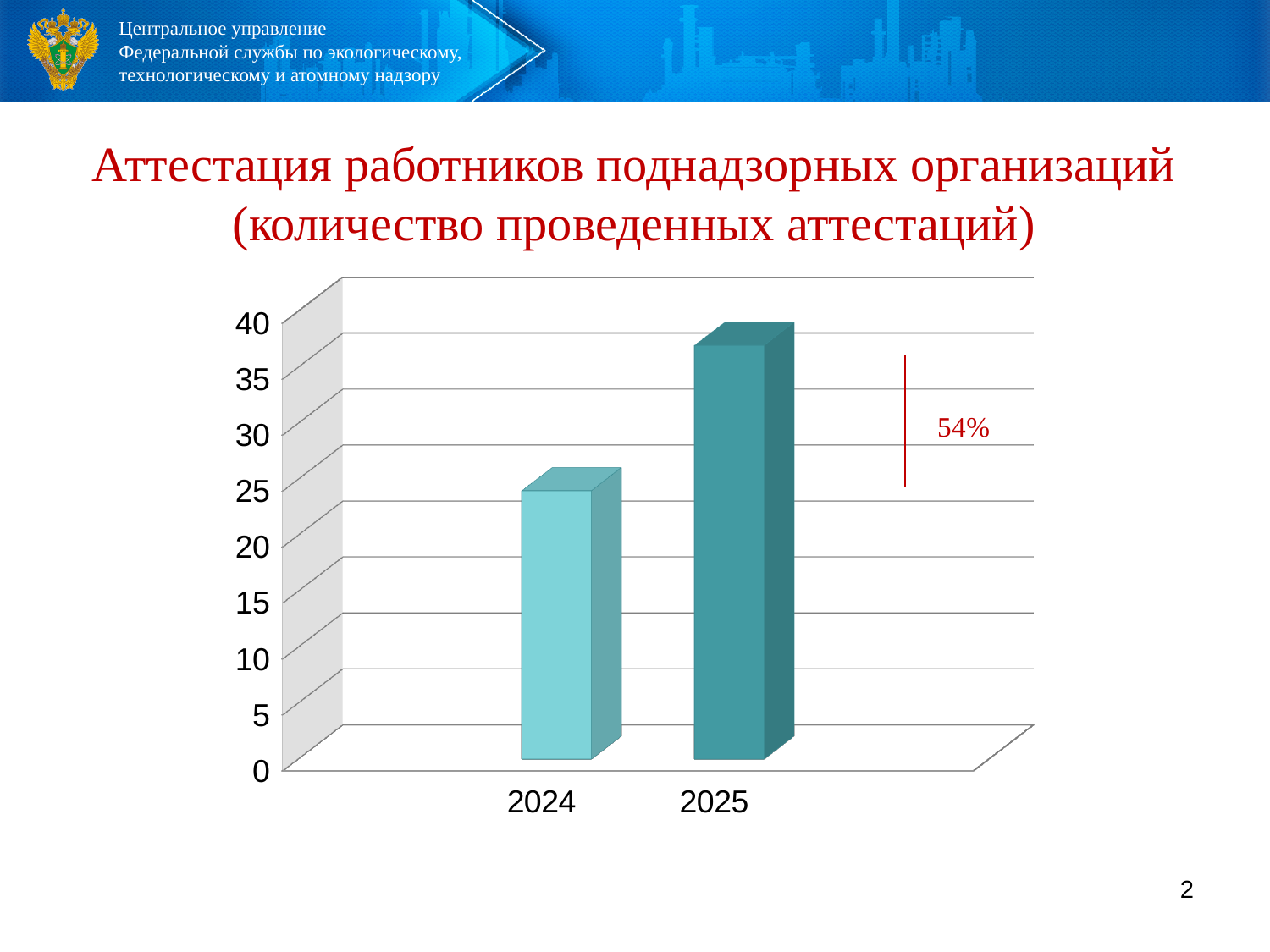
Is the value for 2024 greater or less than 30? less What kind of chart is shown on the slide? bar chart Is the value for 2024 greater or less than 20? greater Which year has the highest number of attestations in the chart? 2025 Do the values rise or fall from 2024 to 2025? rise Which is larger, the value for 2024 or the value for 2025? 2025 Which year has the lowest number of attestations in the chart? 2024 Is the value for 2025 greater or less than 30? greater How many categories (years) are shown on the x axis of the chart? 2 What is the title of the chart on the slide? Аттестация работников поднадзорных организаций (количество проведенных аттестаций) What percentage is written in red next to the bars on the chart? 54%